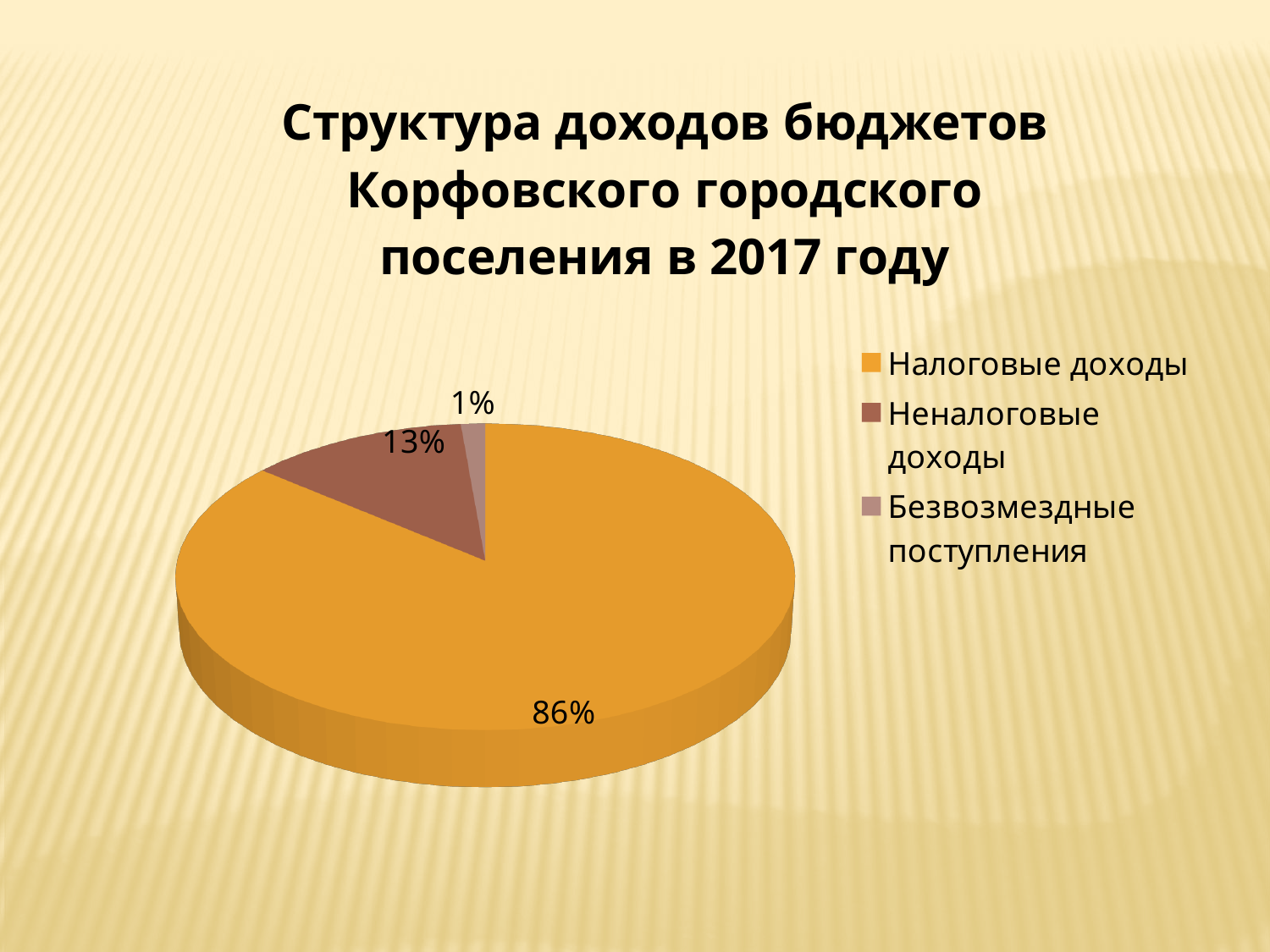
Which legend entry is shown in orange? Налоговые доходы Which category has the smallest slice of the pie? Безвозмездные поступления What share of the pie does Безвозмездные поступления have? 1% What share of the pie does Налоговые доходы have? 86% How many categories does the pie chart show? 3 What kind of chart is shown on the slide? Pie chart What share of the pie does Неналоговые доходы have? 13% What is the difference in percentage points between Налоговые доходы and Неналоговые доходы? 73 Which is larger, Неналоговые доходы or Безвозмездные поступления? Неналоговые доходы What is the difference in percentage points between Неналоговые доходы and Безвозмездные поступления? 12 Which category has the largest slice of the pie? Налоговые доходы What is the title of the chart on the slide? Структура доходов бюджетов Корфовского городского поселения в 2017 году